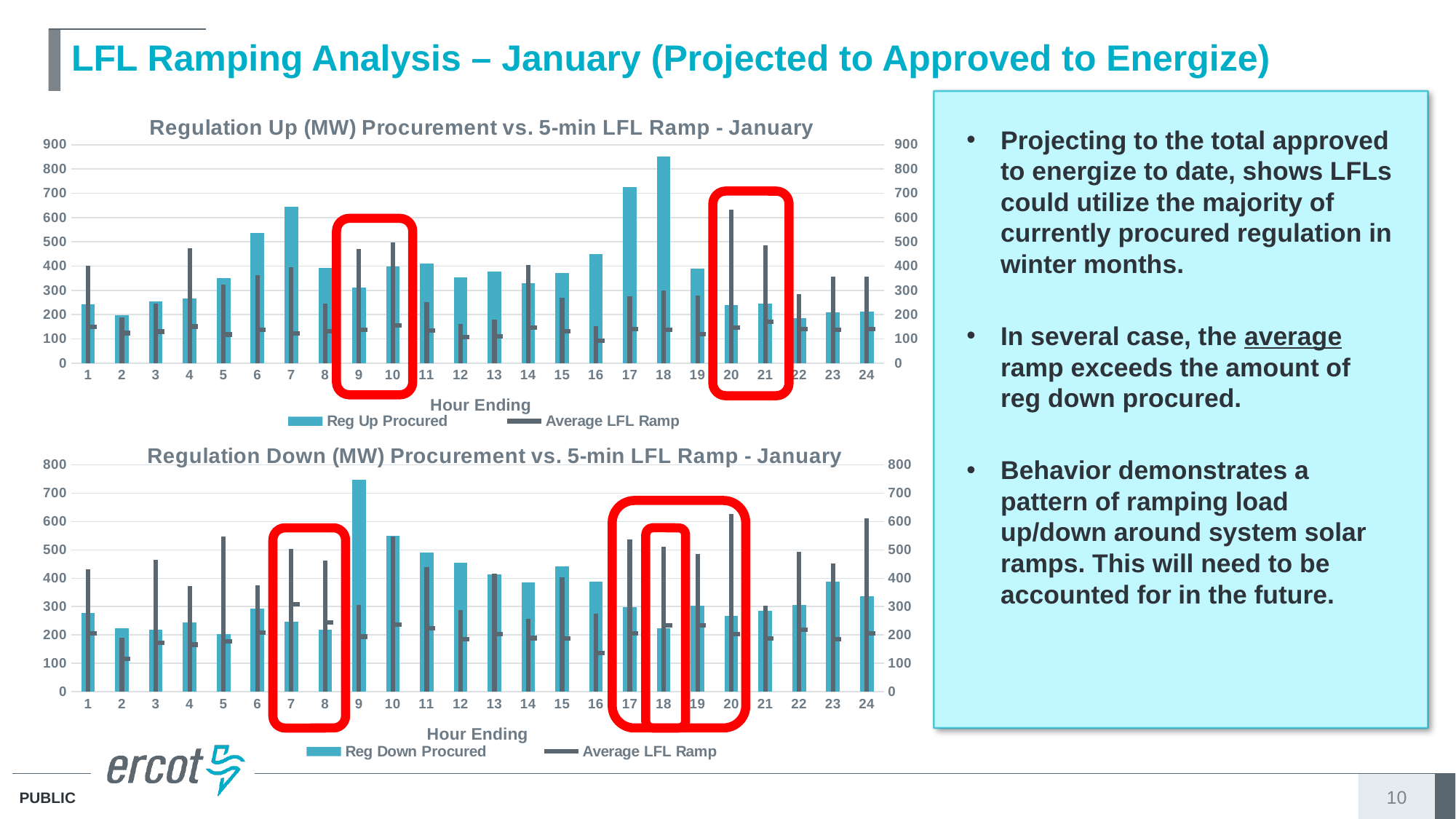
In the Regulation Up chart, which hour ending has the highest Reg Up Procured value? 18 In the Regulation Down chart, is the Reg Down Procured value for hour ending 9 greater or less than 700? greater In the Regulation Up chart, is the Reg Up Procured value for hour ending 2 greater or less than 300? less In the Regulation Down chart, is the Reg Down Procured value for hour ending 5 greater or less than 300? less What kind of chart is the Regulation Up (MW) Procurement vs. 5-min LFL Ramp chart? Bar chart In the Regulation Down chart, which hour ending has the highest Reg Down Procured value? 9 In the Regulation Up chart, which has the larger Reg Up Procured value, hour ending 6 or hour ending 7? Hour ending 7 How many series does the legend of the Regulation Down chart list? 2 How many hour-ending categories are shown on the x axis of the Regulation Up chart? 24 What is the x-axis title of the Regulation Down chart? Hour Ending In the Regulation Down chart, which has the larger Reg Down Procured value, hour ending 9 or hour ending 10? Hour ending 9